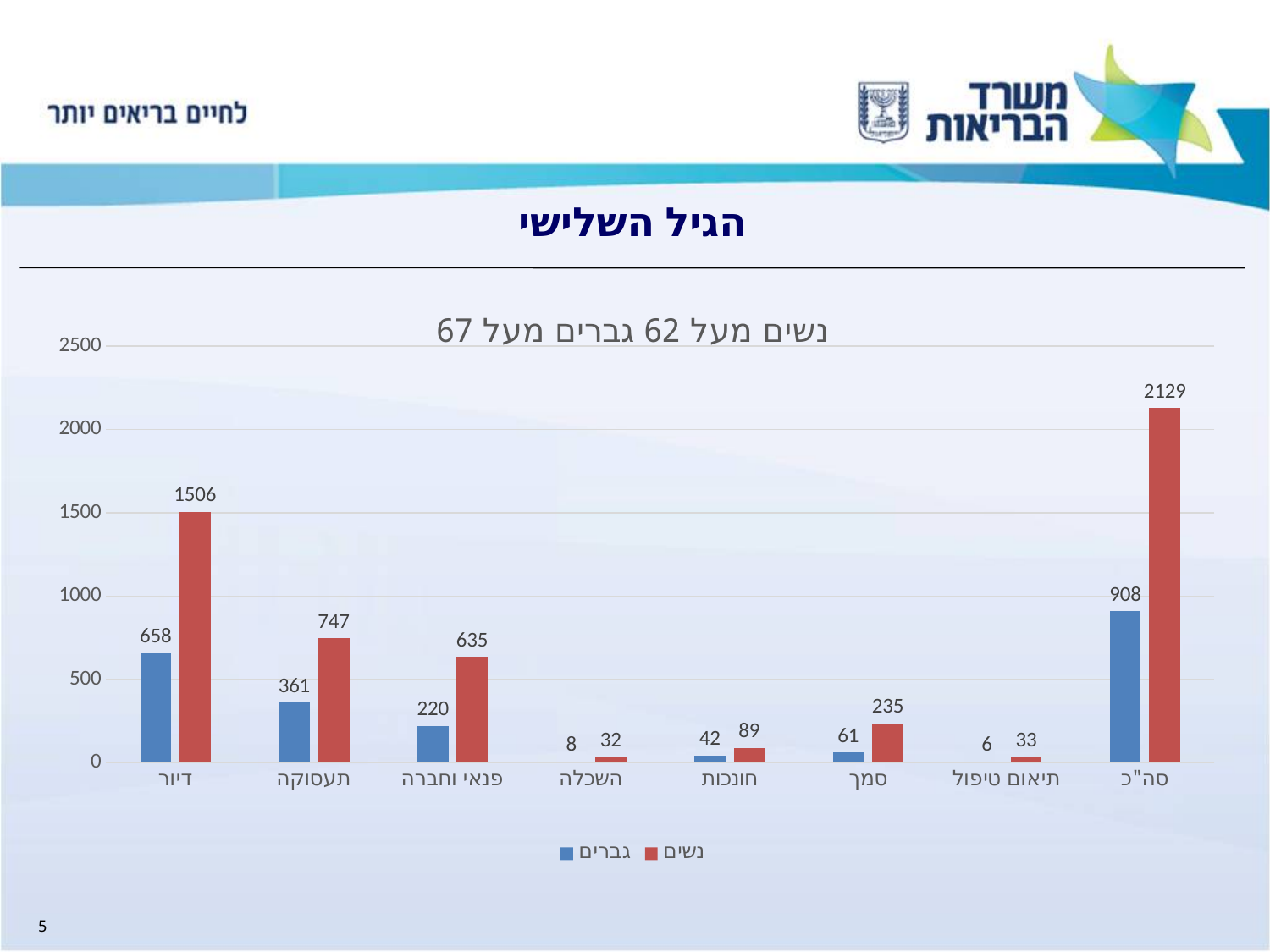
Which is larger: the גברים value for דיור or the נשים value for תעסוקה? נשים value for תעסוקה Which category has the lowest value for גברים? תיאום טיפול What kind of chart is shown on the slide? Bar chart What is the difference between the נשים and גברים values in the סה"כ category? 1221 What is the difference between the נשים and גברים values in the פנאי וחברה category? 415 What is the value for נשים in the סמך category? 235 How many categories are shown on the x axis? 8 How many series does the legend list? 2 Excluding the סה"כ total, which category has the highest value for נשים? דיור What is the value for גברים in the תעסוקה category? 361 What is the value for נשים in the דיור category? 1506 What is the title of the chart? נשים מעל 62 גברים מעל 67